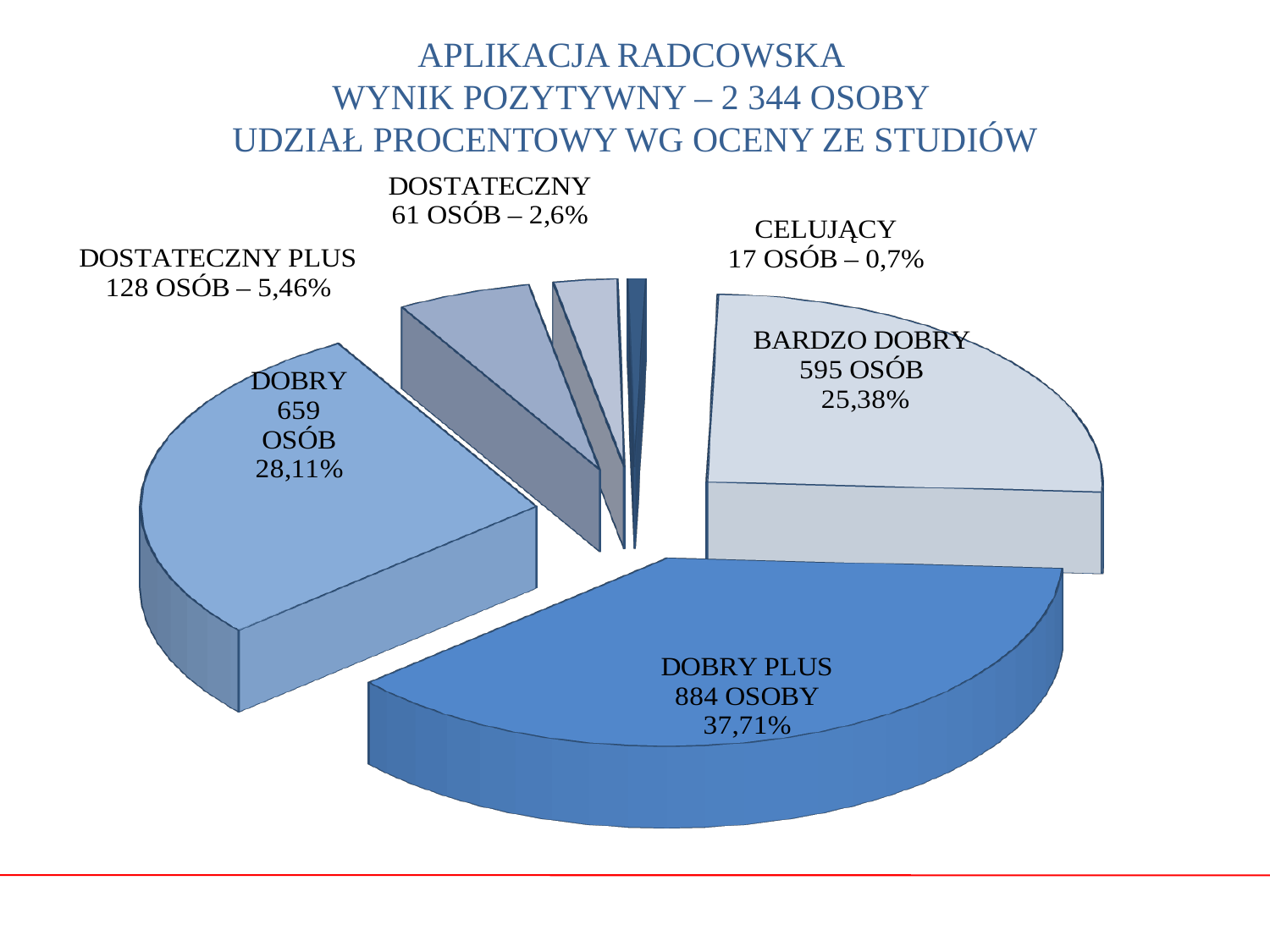
How many people are in the CELUJĄCY category? 17 What percentage share does the BARDZO DOBRY slice have? 25,38% How many grade categories are shown in the pie chart? 6 What is the difference in the number of people between DOBRY PLUS and DOBRY? 225 Which grade category has the largest slice of the pie? DOBRY PLUS What percentage share does the DOSTATECZNY PLUS slice have? 5,46% Which grade category has the smallest slice of the pie? CELUJĄCY What is the difference in the number of people between DOSTATECZNY PLUS and DOSTATECZNY? 67 Which category has more people, BARDZO DOBRY or DOSTATECZNY PLUS? BARDZO DOBRY According to the chart title, how many people in total achieved a positive result? 2 344 What kind of chart is shown on the slide? pie chart How many people received the grade DOBRY PLUS? 884